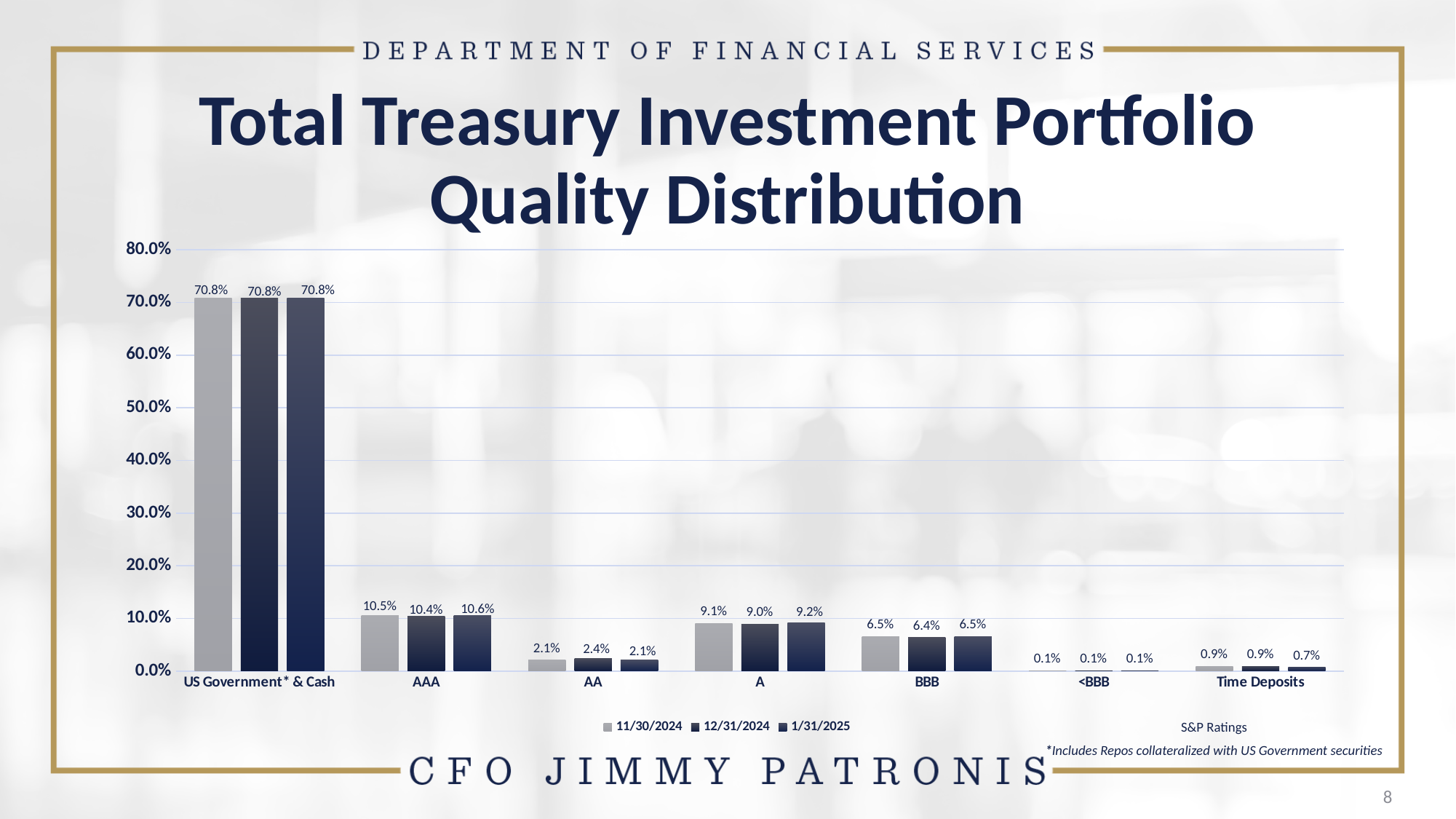
What is the title of the chart? Total Treasury Investment Portfolio Quality Distribution Which category has the lowest value in the 11/30/2024 series? <BBB How many series does the legend list? 3 What is the value for AAA in the 1/31/2025 series? 10.6% Which is larger in the 12/31/2024 series, AAA or A? AAA What is the difference between the 1/31/2025 values for A and BBB? 2.7% How many categories are shown on the x axis? 7 What is the value for AA in the 12/31/2024 series? 2.4% What kind of chart is shown on the slide? Bar chart What is the value for Time Deposits in the 1/31/2025 series? 0.7% Which category has the highest value in the 1/31/2025 series? US Government* & Cash What is the value for US Government* & Cash in the 11/30/2024 series? 70.8%